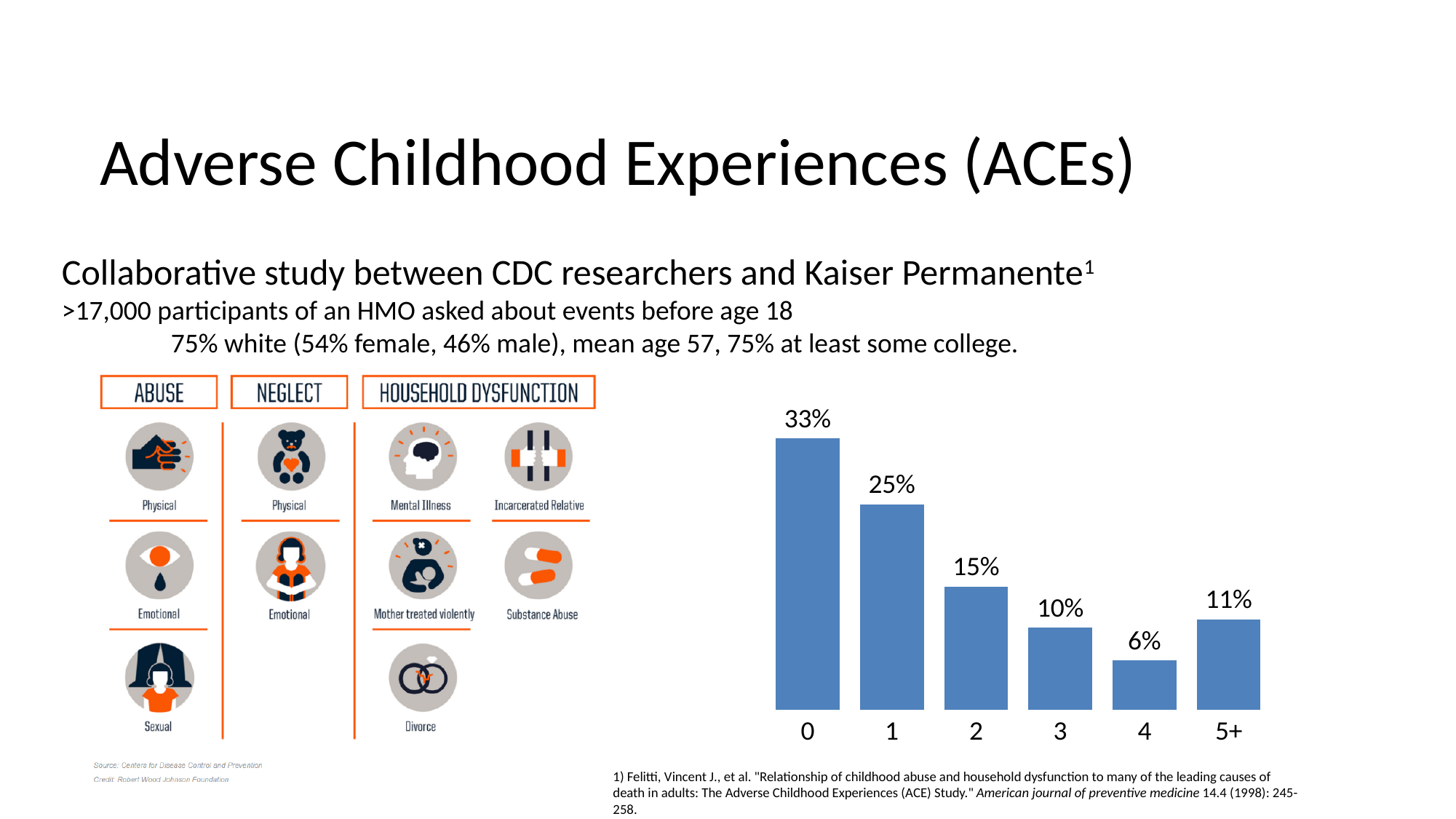
What is the difference between the values for category 5+ and category 4 in the bar chart? 5% How many categories are shown on the x axis of the bar chart? 6 What is the difference between the values for category 0 and category 1 in the bar chart? 8% Which category has the lowest value in the bar chart? 4 Which category has the highest value in the bar chart? 0 Which is larger in the bar chart, the value for category 3 or the value for category 5+? 5+ What kind of chart is shown on the right side of the slide? bar chart What is the value for category 5+ in the bar chart? 11% What is the value for category 2 in the bar chart? 15% What is the value for category 0 in the bar chart? 33% Do the values in the bar chart rise or fall from category 0 to category 4? fall What colour are the bars in the bar chart? blue